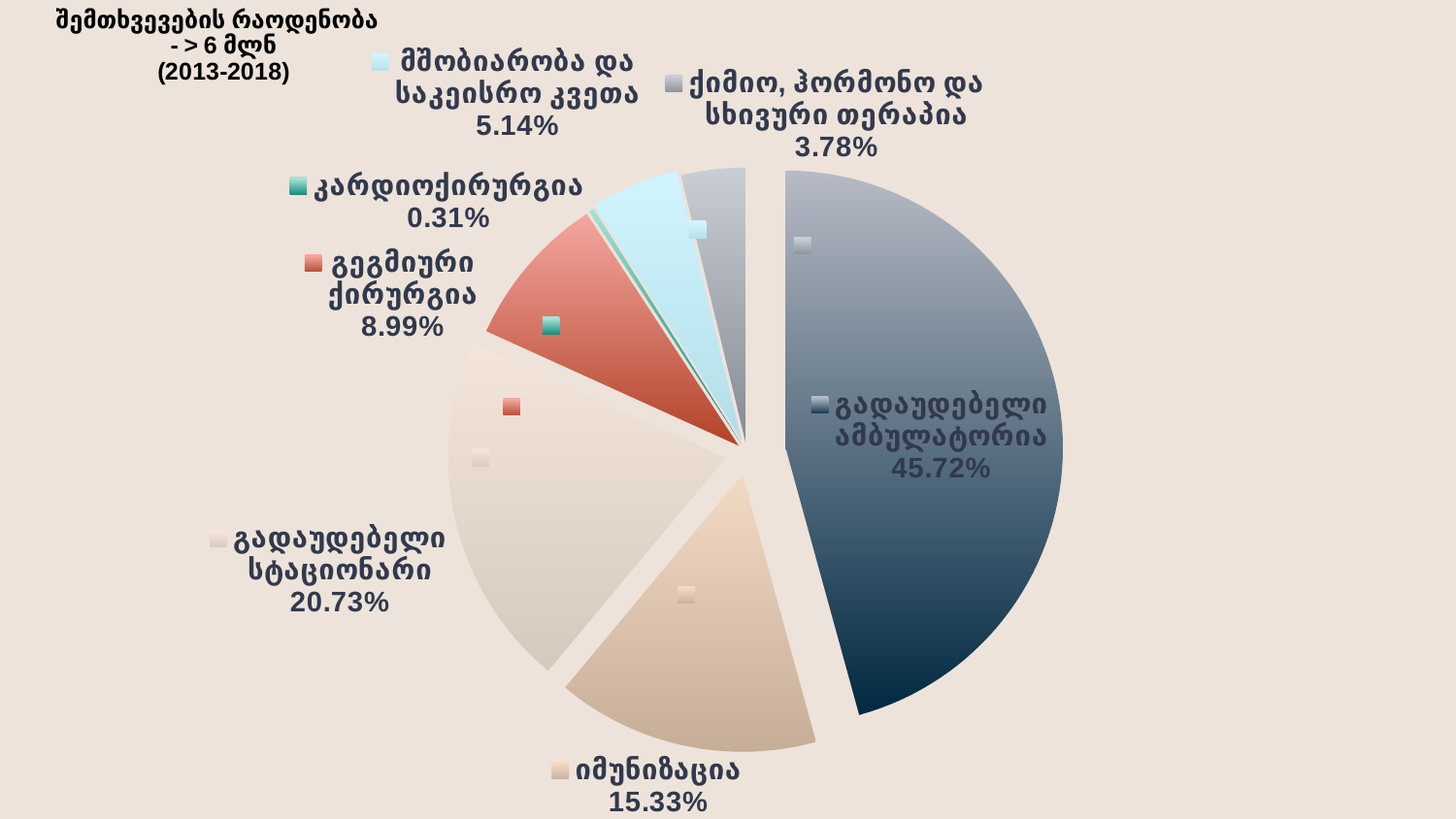
What is the difference between the shares of გადაუდებელი სტაციონარი and იმუნიზაცია? 5.40% Which category has the largest slice of the pie? გადაუდებელი ამბულატორია What is the value shown for იმუნიზაცია? 15.33% What is the value shown for გეგმიური ქირურგია? 8.99% What is the value shown for მშობიარობა და საკეისრო კვეთა? 5.14% What share of the pie does გადაუდებელი ამბულატორია have? 45.72% How many slices does the pie chart have? 7 What is the value shown for გადაუდებელი სტაციონარი? 20.73% What period is given in the chart title? 2013-2018 Which category has the smallest slice of the pie? კარდიოქირურგია Which is larger, the share for გეგმიური ქირურგია or the share for ქიმიო, ჰორმონო და სხივური თერაპია? გეგმიური ქირურგია What kind of chart is shown on the slide? pie chart